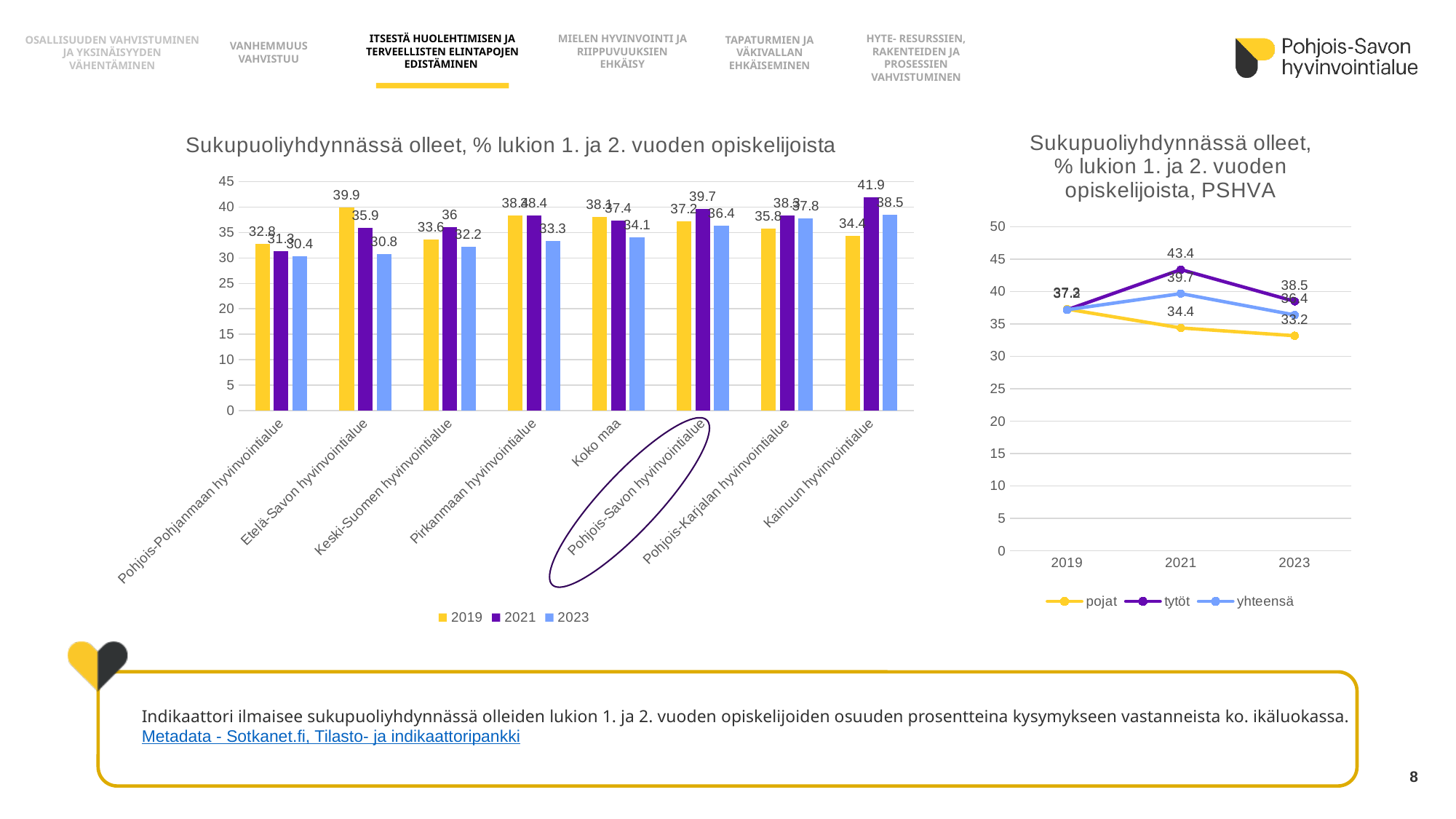
How many series does the legend of the bar chart on the left list? 3 In the bar chart on the left, which category has the highest 2021 value? Kainuun hyvinvointialue In the bar chart on the left, what is the 2023 value for Etelä-Savon hyvinvointialue? 30.8 In the bar chart on the left, which has the larger 2021 value: Pohjois-Savon hyvinvointialue or Koko maa? Pohjois-Savon hyvinvointialue How many categories are shown on the x axis of the bar chart on the left? 8 In the bar chart on the left, what is the 2021 value for Kainuun hyvinvointialue? 41.9 In the line chart on the right, does the pojat line rise or fall from 2019 to 2023? Falls In the line chart on the right, what is the value for tytöt in 2021? 43.4 In the line chart on the right, what is the difference between tytöt and pojat in 2023? 5.3 What kind of chart is the chart on the right (PSHVA)? Line chart In the bar chart on the left, how much higher is the 2021 value than the 2019 value for Kainuun hyvinvointialue? 7.5 In the bar chart on the left, which category has the lowest 2023 value? Pohjois-Pohjanmaan hyvinvointialue